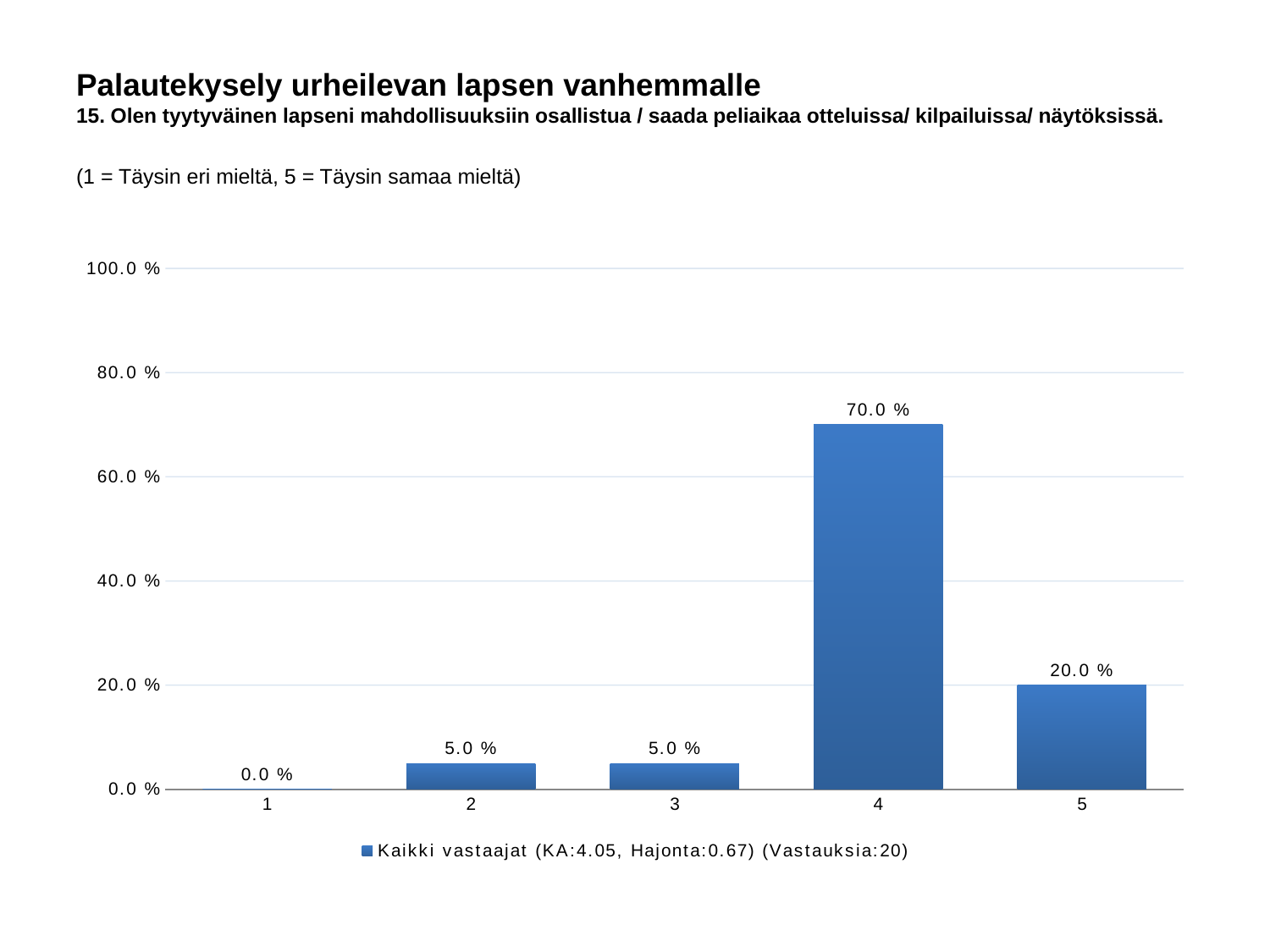
How many series does the legend list? 1 Which category has the highest value? 4 Is the value for category 4 greater or less than 60.0 %? greater What kind of chart is shown on the slide? bar chart Which is larger, the value for category 2 or the value for category 5? 5 How many categories are shown on the x axis? 5 How many responses (Vastauksia) does the legend report? 20 What is the difference between the values for category 4 and category 5? 50.0 % Which category has the lowest value? 1 What is the value for category 4? 70.0 % What is the value for category 1? 0.0 % What is the value for category 5? 20.0 %